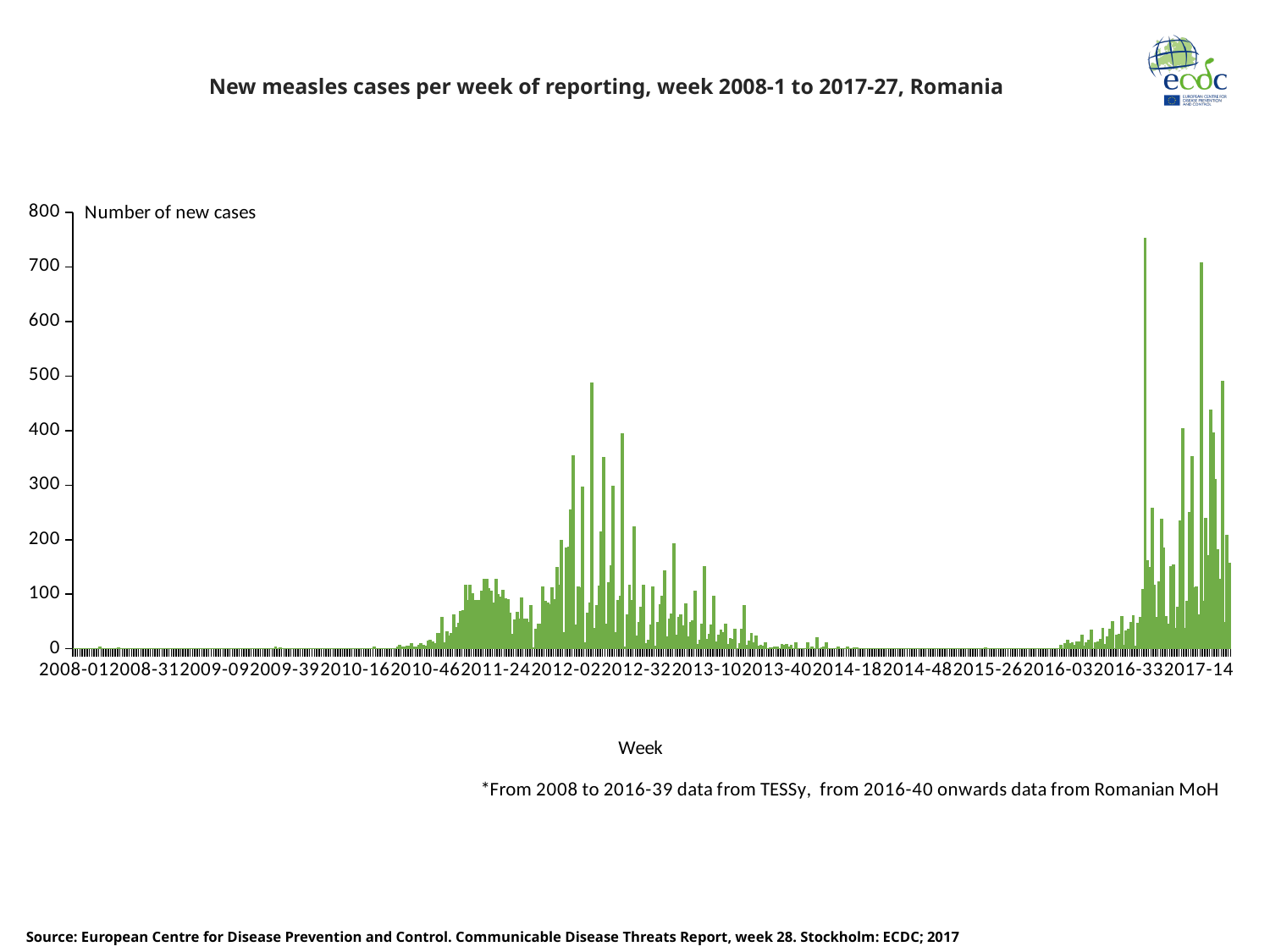
Is the tallest bar in the chart greater or less than 800? less What is the title of the chart? New measles cases per week of reporting, week 2008-1 to 2017-27, Romania Is the tallest bar in the chart greater or less than 700? greater What kind of chart is shown on the slide? Bar chart How many week labels are printed along the horizontal axis? 17 Are the bars for weeks in 2014 and 2015 greater or less than 100? less What is the first week label on the horizontal axis? 2008-01 What is the highest value shown on the vertical axis? 800 Which period has the tallest bar: the 2012 outbreak or the 2016-2017 outbreak? 2016-2017 outbreak What is the label of the vertical axis? Number of new cases